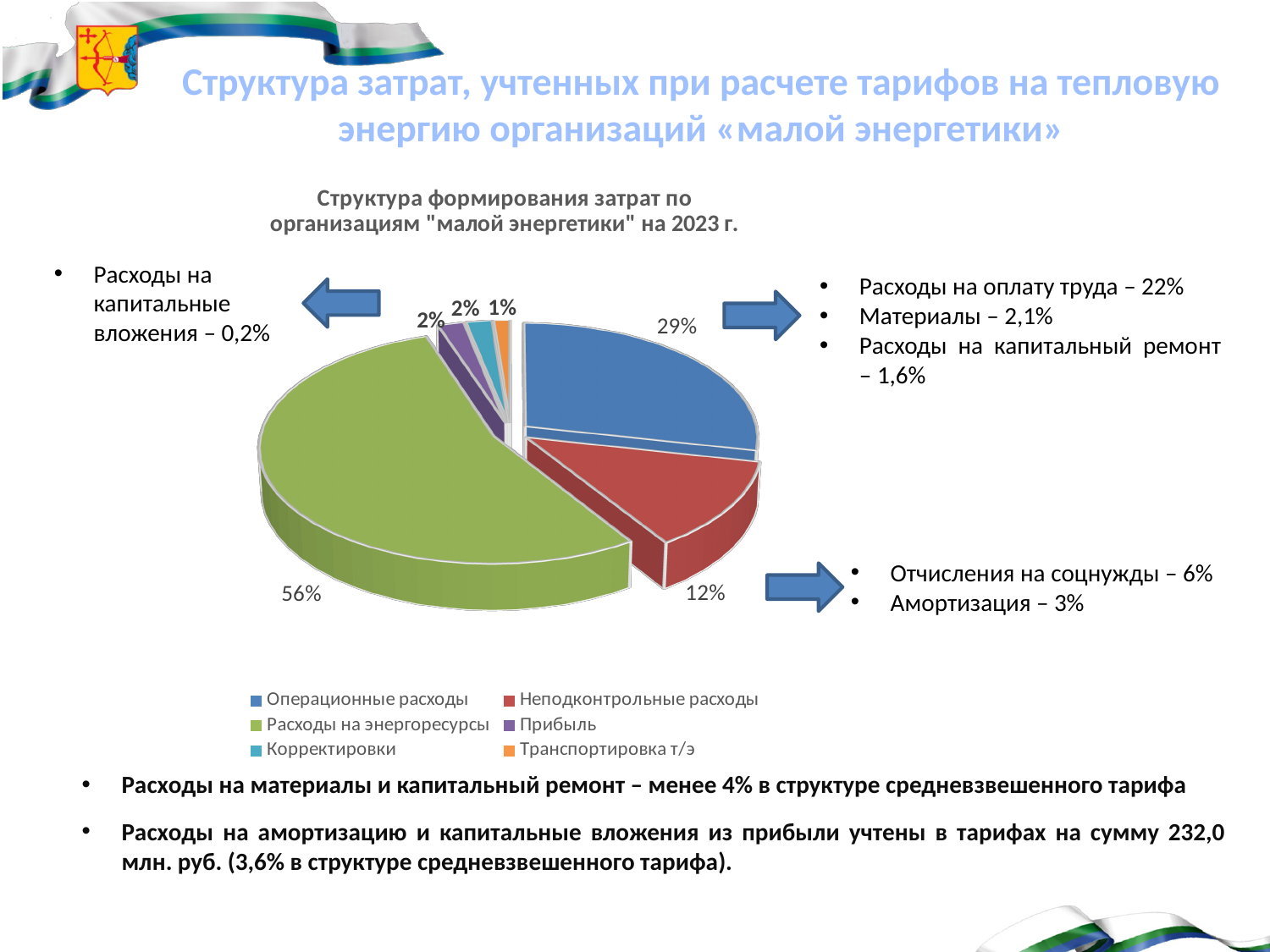
What share of the pie is Операционные расходы? 29% How many slices does the pie chart have? 6 Which category has the largest slice of the pie? Расходы на энергоресурсы What share of the pie is Неподконтрольные расходы? 12% Which category has the smallest slice of the pie? Транспортировка т/э How many entries does the chart legend list? 6 What kind of chart is shown on the slide? Pie chart What is the difference between the shares of Расходы на энергоресурсы and Операционные расходы? 27% Which is larger: the share of Операционные расходы or the share of Неподконтрольные расходы? Операционные расходы What share of the pie is Расходы на энергоресурсы? 56% What is the title of the chart? Структура формирования затрат по организациям "малой энергетики" на 2023 г. What share of the pie is Транспортировка т/э? 1%